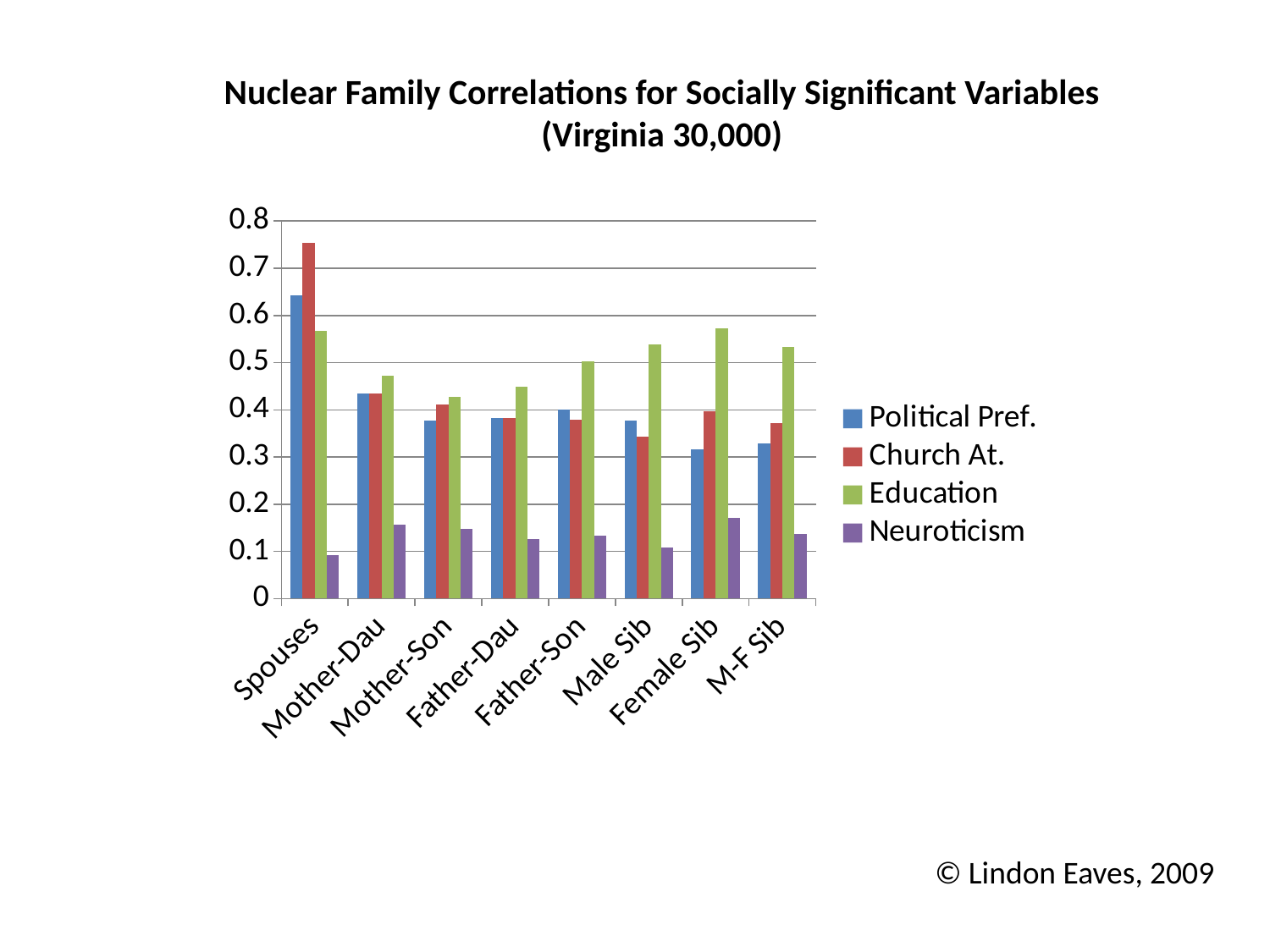
How many series does the legend list? 4 How many family relationship categories are shown on the x axis? 8 What colour represents the Education series in the legend? green For Spouses, which is larger: the Church At. value or the Political Pref. value? Church At. For which category is the Church At. correlation highest? Spouses Is the Church At. value for Spouses greater or less than 0.7? greater Is the Education value for Female Sib greater or less than 0.5? greater For Male Sib, which is larger: the Education value or the Political Pref. value? Education Is the Political Pref. value for Female Sib greater or less than 0.4? less What kind of chart is shown on the slide? bar chart For which category is the Political Pref. correlation highest? Spouses